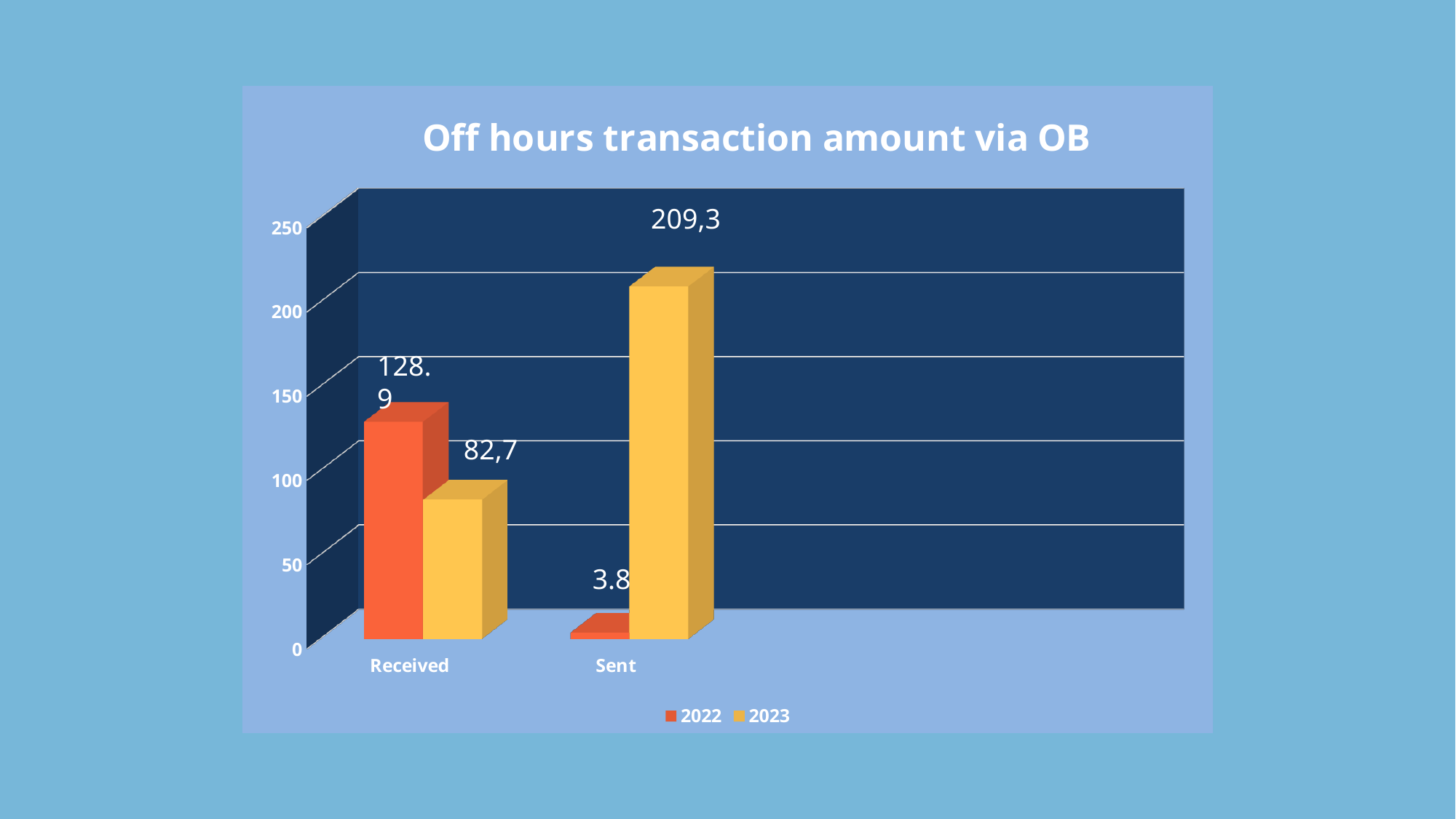
How many series does the legend list? 2 Is the value for Sent in 2023 greater or less than 200? greater Which category has the lowest value in the 2022 series? Sent Which category has the highest value in the 2023 series? Sent Which is larger for Received: the 2022 value or the 2023 value? 2022 What is the difference between the 2023 values for Sent and Received? 126,6 What is the value for Sent in 2023? 209,3 How many categories are shown on the x axis? 2 What kind of chart is shown on the slide? bar chart What is the value for Received in 2023? 82,7 What is the value for Received in 2022? 128.9 What is the value for Sent in 2022? 3.8